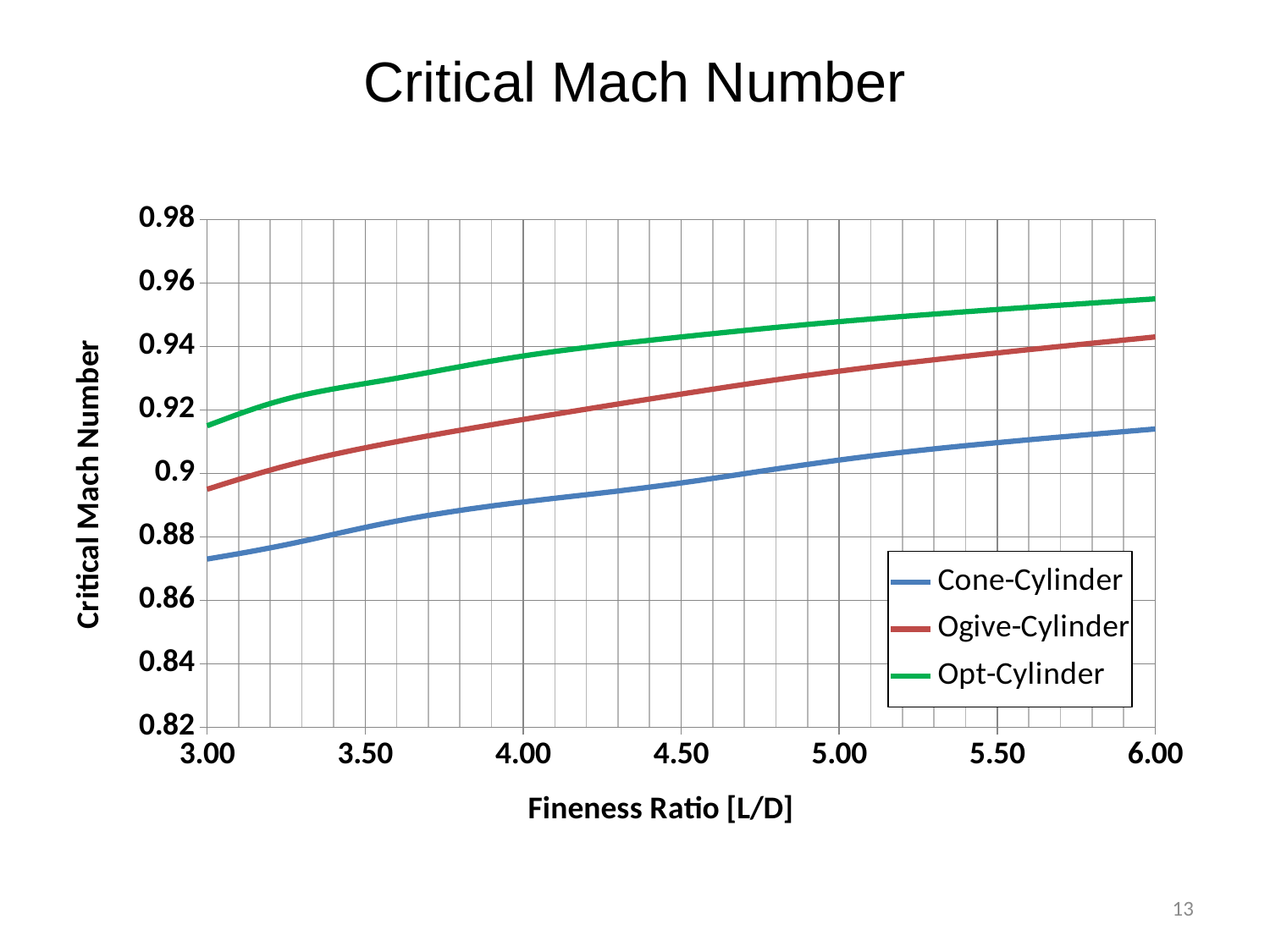
What is the label of the x axis? Fineness Ratio [L/D] Which series has the highest critical Mach number across the whole fineness ratio range? Opt-Cylinder Does the critical Mach number for Cone-Cylinder rise or fall as the fineness ratio increases from 3.00 to 6.00? rise At a fineness ratio of 4.00, which is larger: the critical Mach number for Opt-Cylinder or for Cone-Cylinder? Opt-Cylinder Is the critical Mach number for Cone-Cylinder at a fineness ratio of 6.00 greater or less than 0.9? greater Is the critical Mach number for Cone-Cylinder at a fineness ratio of 3.00 greater or less than 0.88? less How many series does the legend list? 3 What is the title of the chart? Critical Mach Number Is the critical Mach number for Opt-Cylinder at a fineness ratio of 6.00 greater or less than 0.94? greater What kind of chart is shown on the slide? line chart Which series has the lowest critical Mach number across the whole fineness ratio range? Cone-Cylinder